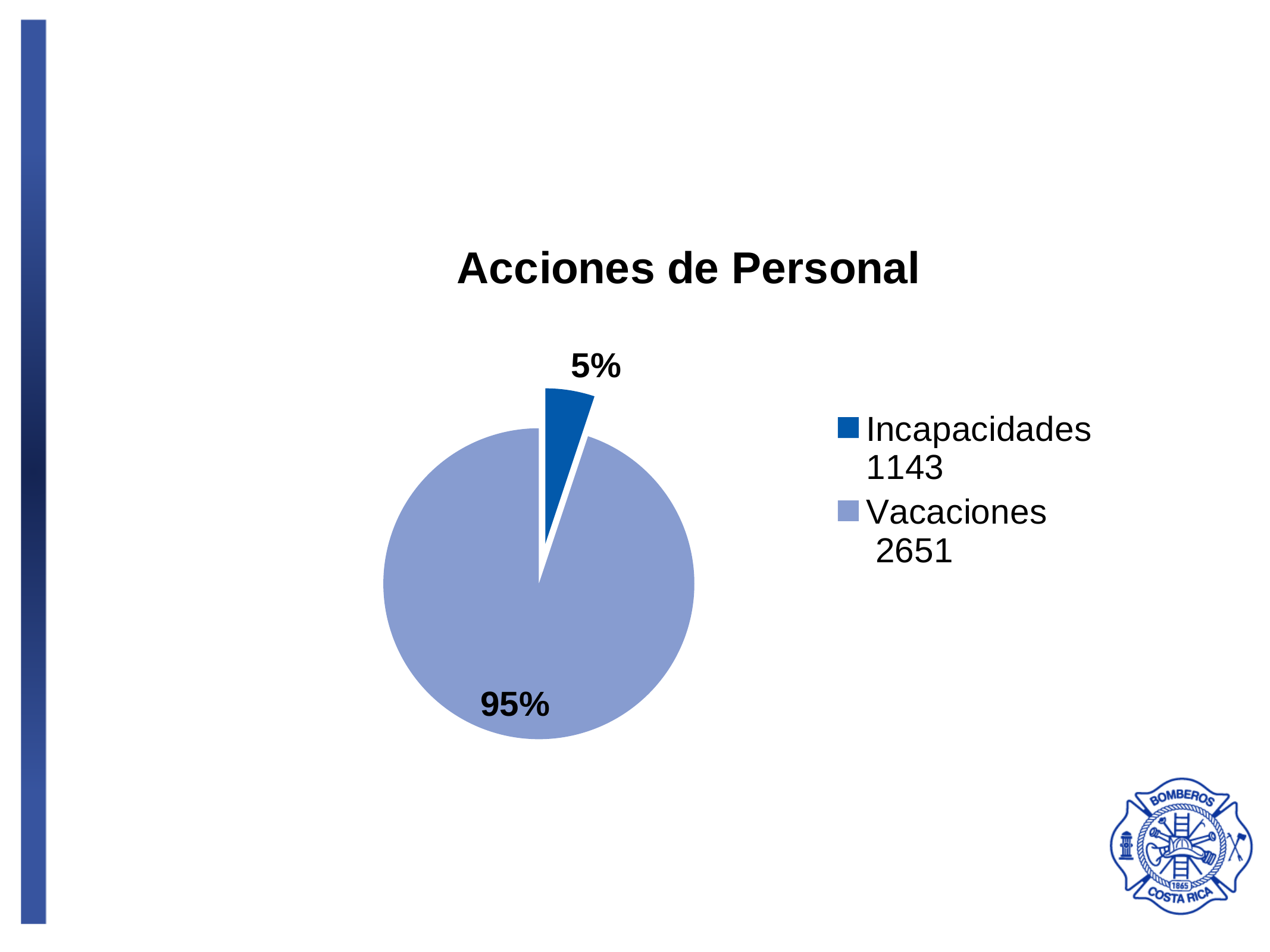
Which slice is the smallest in the pie chart? Incapacidades What number appears next to Vacaciones in the legend? 2651 What kind of chart is shown on the slide? pie chart What is the title of the chart? Acciones de Personal What percentage of the pie does the Incapacidades slice represent? 5% Which slice is the largest in the pie chart? Vacaciones How many slices does the pie chart have? 2 Which slice is larger, Incapacidades or Vacaciones? Vacaciones What is the difference in percentage points between the Vacaciones slice and the Incapacidades slice? 90 What percentage of the pie does the Vacaciones slice represent? 95% How many entries does the legend list? 2